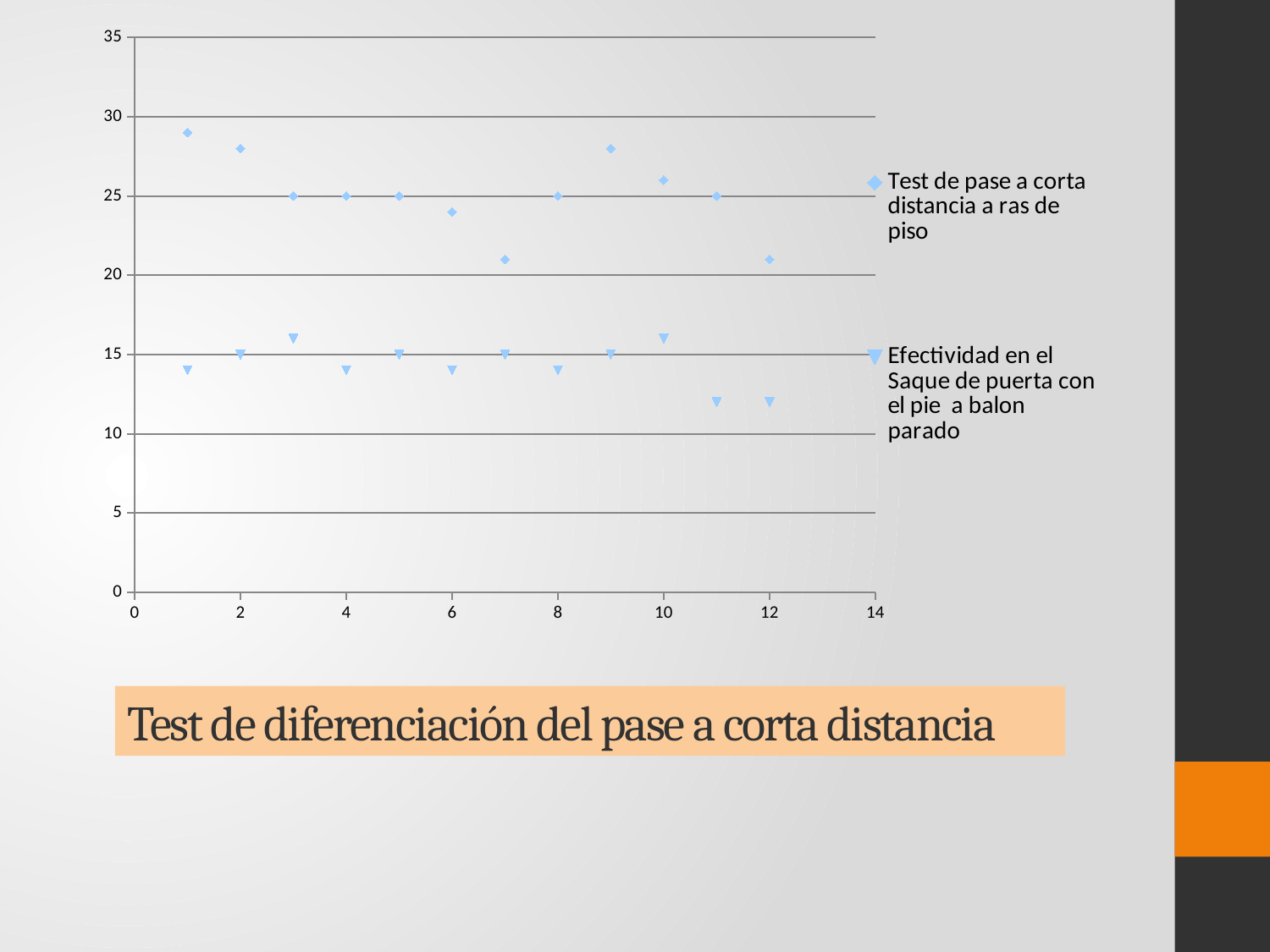
What is the maximum value shown on the vertical axis of the chart? 35 How many series does the legend list? 2 At x = 1, which series has the larger value: 'Test de pase a corta distancia a ras de piso' or 'Efectividad en el Saque de puerta con el pie a balon parado'? Test de pase a corta distancia a ras de piso Is the value of 'Test de pase a corta distancia a ras de piso' at x = 1 greater or less than 25? greater Is the value of 'Efectividad en el Saque de puerta con el pie a balon parado' at x = 11 greater or less than 15? less How many points are plotted for the series 'Test de pase a corta distancia a ras de piso'? 12 Is the value of 'Test de pase a corta distancia a ras de piso' at x = 12 greater or less than 25? less What kind of chart is shown on the slide? scatter chart What is the value of 'Test de pase a corta distancia a ras de piso' at x = 3? 25 What title is shown in the box below the chart? Test de diferenciación del pase a corta distancia What is the value of 'Efectividad en el Saque de puerta con el pie a balon parado' at x = 2? 15 How many points are plotted for the series 'Efectividad en el Saque de puerta con el pie a balon parado'? 12